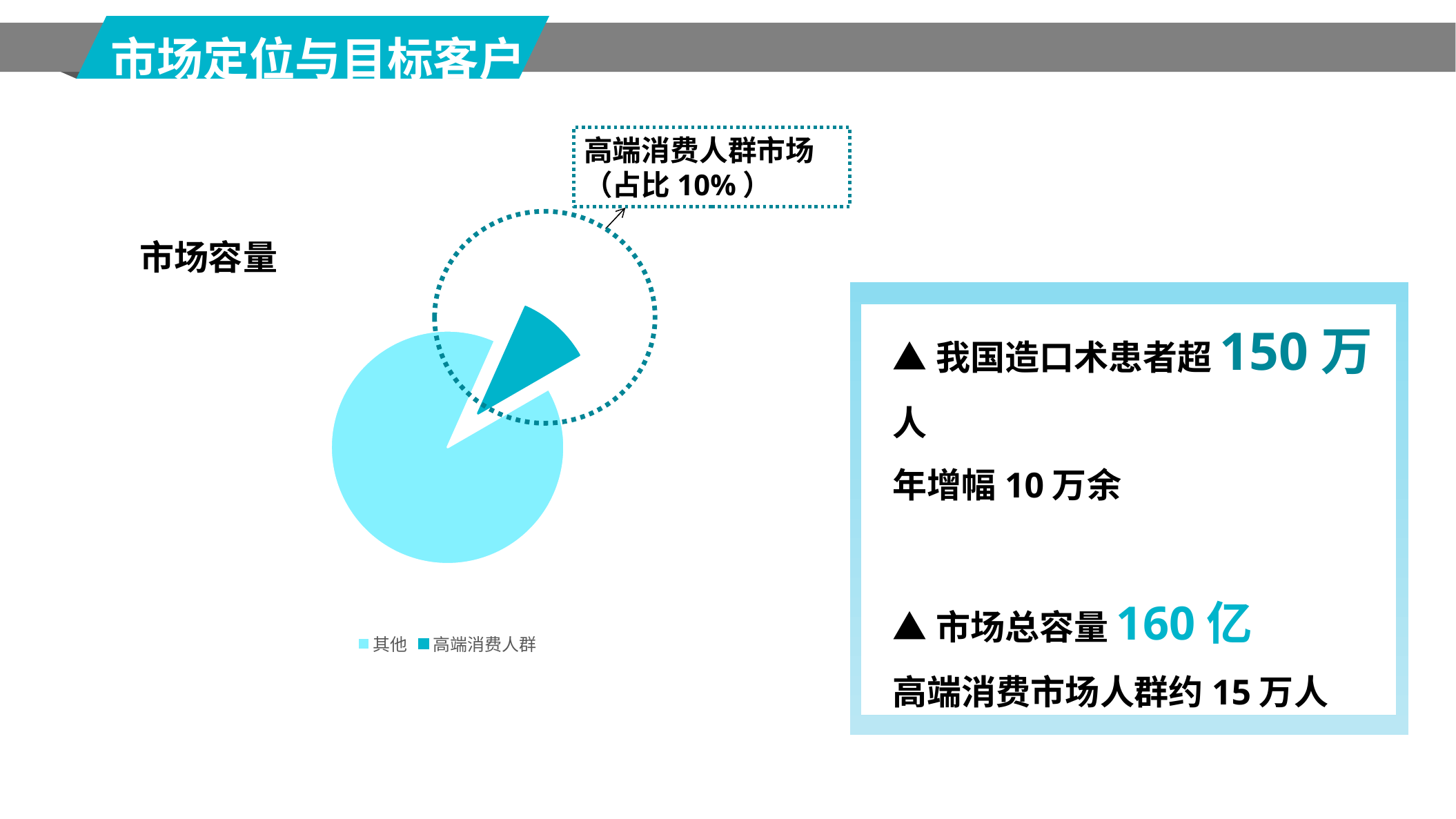
How many entries does the chart legend list? 2 What kind of chart is shown on the slide? pie chart What is the title of the chart? 市场容量 Which is larger, the 其他 slice or the 高端消费人群 slice? 其他 Which slice of the pie chart is the largest? 其他 Which slice is pulled out (exploded) from the pie? 高端消费人群 Which slice of the pie chart is the smallest? 高端消费人群 How many slices does the pie chart have? 2 What share of the pie does 高端消费人群 represent? 10% What are the two legend entries of the pie chart? 其他, 高端消费人群 Is the share for 高端消费人群 greater or less than 50%? less